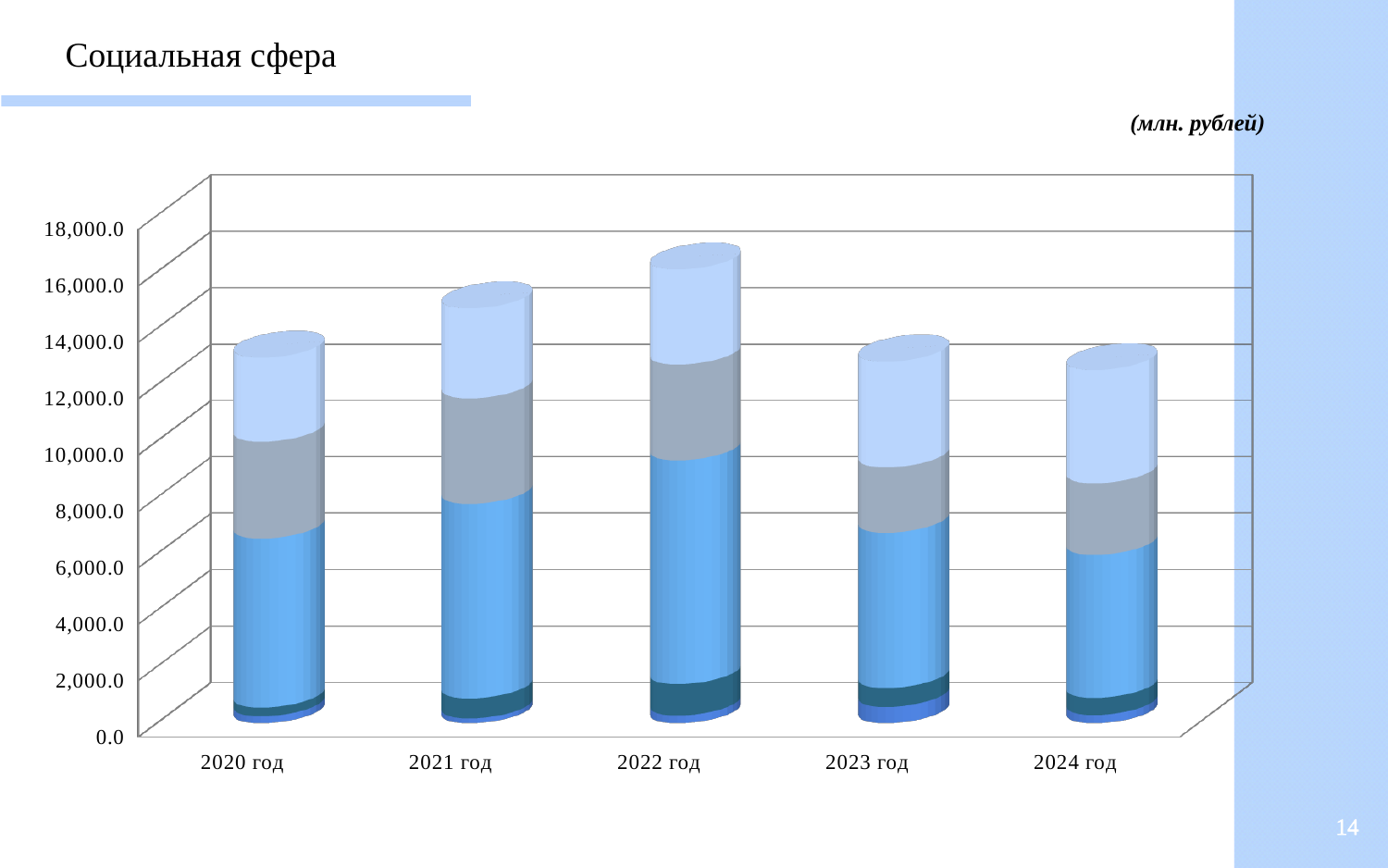
Is the total for 2021 год greater or less than 14,000.0? greater Which bar is taller, 2022 год or 2020 год? 2022 год What is the highest value labelled on the vertical axis of the chart? 18,000.0 How do the bar totals change from 2020 год to 2022 год? They rise Is the total for 2020 год greater or less than 16,000.0? less How many years (categories) are shown on the x axis of the chart? 5 Which bar is taller, 2021 год or 2023 год? 2021 год Is the total for 2024 год greater or less than 14,000.0? less What unit is stated for the values in the chart? млн. рублей Which year has the tallest stacked bar in the chart? 2022 год What kind of chart is shown on the slide? Stacked bar chart